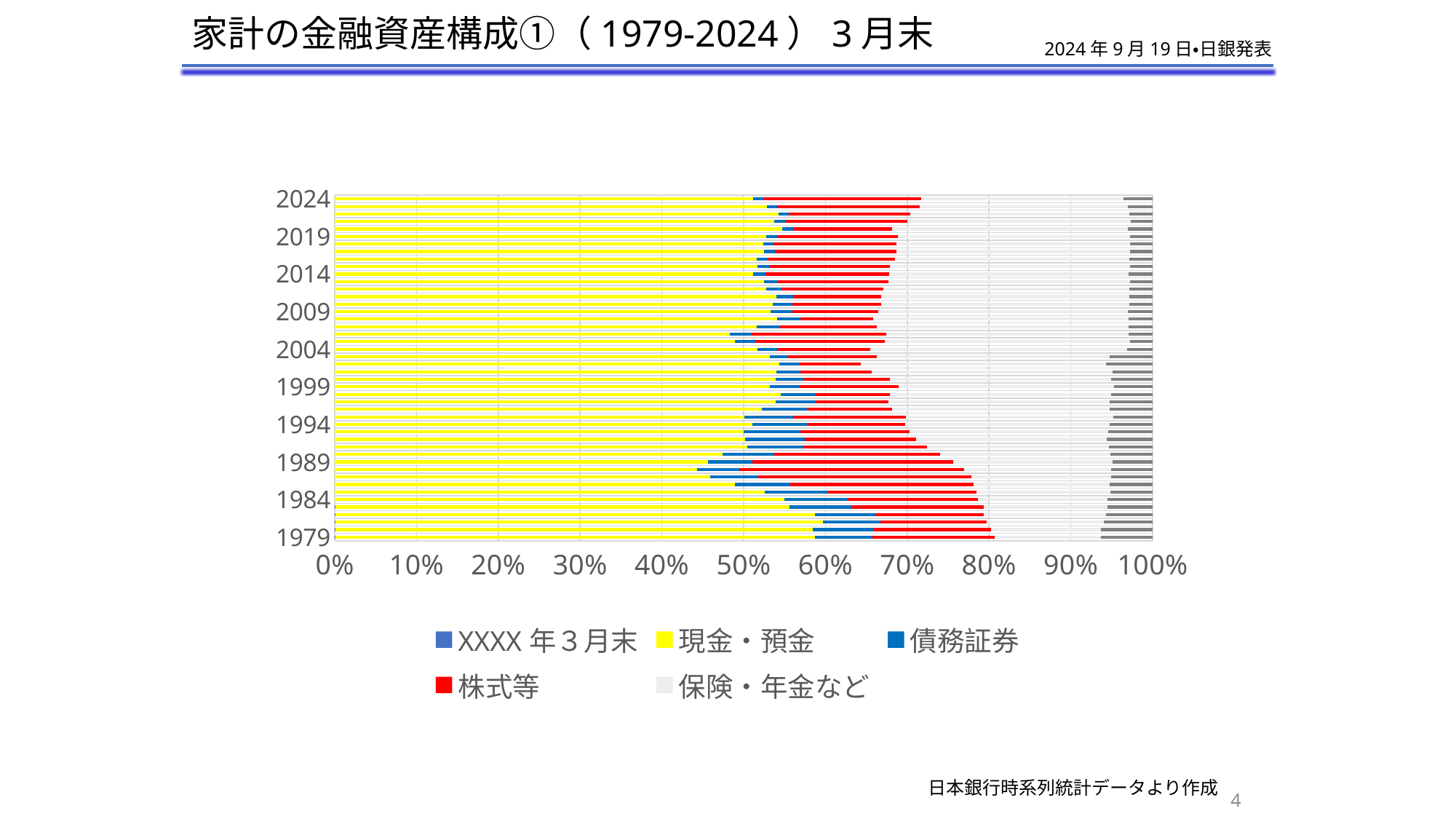
Does the share of 保険・年金など rise or fall from 1979 to 2024? Rise Is the share of 現金・預金 for 1979 greater or less than 50%? greater What kind of chart is shown on the slide? Stacked bar chart Which year has the larger share of 現金・預金, 1979 or 1989? 1979 What is the title of the chart on the slide? 家計の金融資産構成①（1979-2024）3月末 Does the share of 債務証券 rise or fall from 1979 to 2024? Fall How many year labels are shown on the vertical axis? 10 Is the share of 現金・預金 for 2024 greater or less than 60%? less How many series does the legend list? 5 Which year has the larger share of 債務証券, 1984 or 2024? 1984 Which colour represents 株式等 in the chart? Red Is the share of 現金・預金 for 1989 greater or less than 50%? less